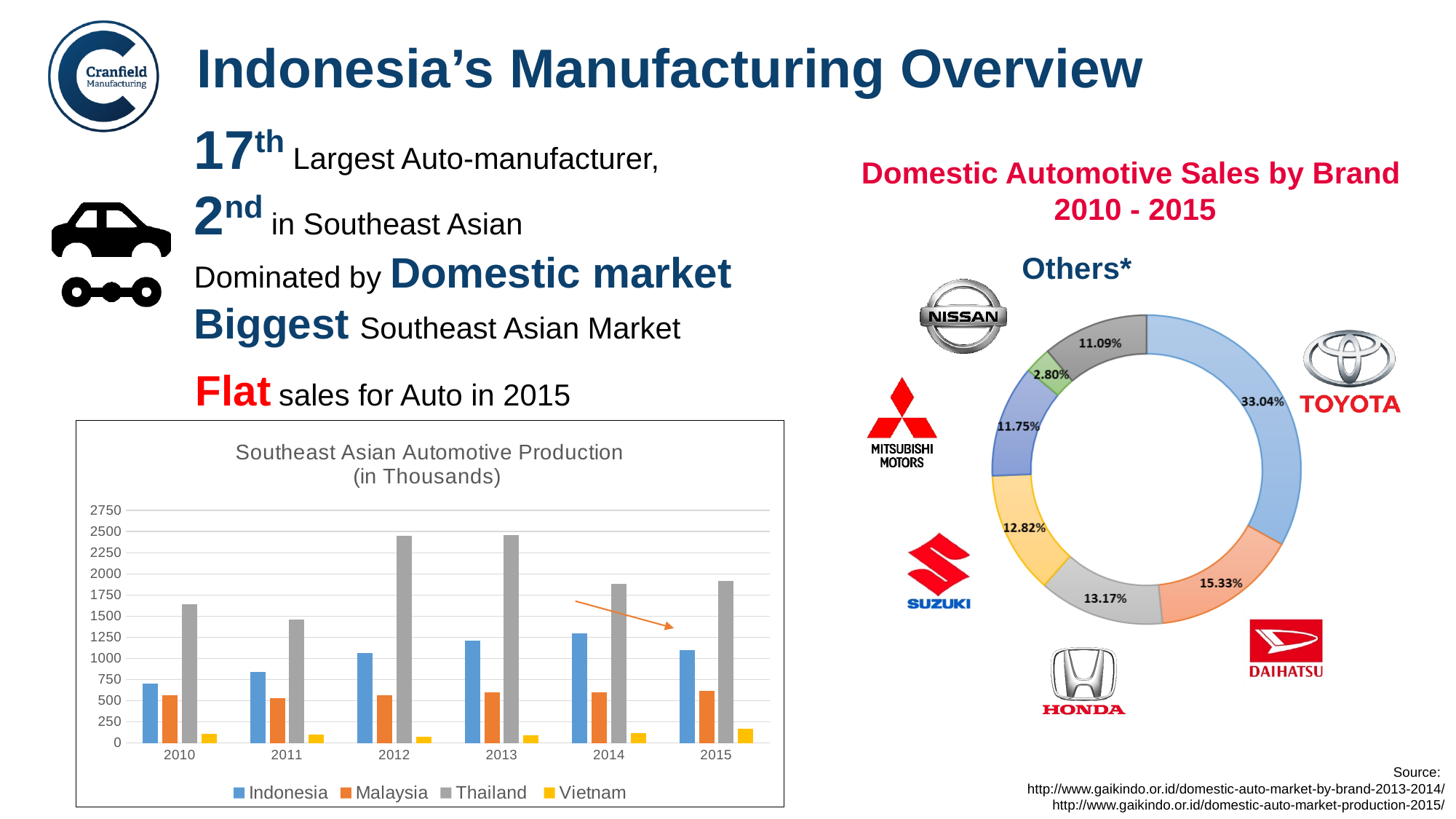
In the 'Domestic Automotive Sales by Brand 2010 - 2015' chart, what is the difference between the Daihatsu share and the Honda share? 2.16% In the 'Southeast Asian Automotive Production' chart, which country has the lowest production in 2015? Vietnam How many years are shown on the x axis of the 'Southeast Asian Automotive Production' chart? 6 In the 'Southeast Asian Automotive Production' chart, which country has the highest production in 2013? Thailand How many series does the legend of the 'Southeast Asian Automotive Production' chart list? 4 In the 'Southeast Asian Automotive Production' chart, is the value for Indonesia in 2010 greater or less than 750? less In the 'Domestic Automotive Sales by Brand 2010 - 2015' chart, what share does Toyota have? 33.04% In the 'Southeast Asian Automotive Production' chart, is the value for Thailand in 2012 greater or less than 2250? greater What kind of chart is the 'Southeast Asian Automotive Production (in Thousands)' chart? bar chart In the 'Southeast Asian Automotive Production' chart, which is larger in 2014: Indonesia or Malaysia? Indonesia In the 'Southeast Asian Automotive Production' chart, does Indonesia's production rise or fall from 2010 to 2014? rise In the 'Domestic Automotive Sales by Brand 2010 - 2015' chart, what share does Nissan have? 2.80%